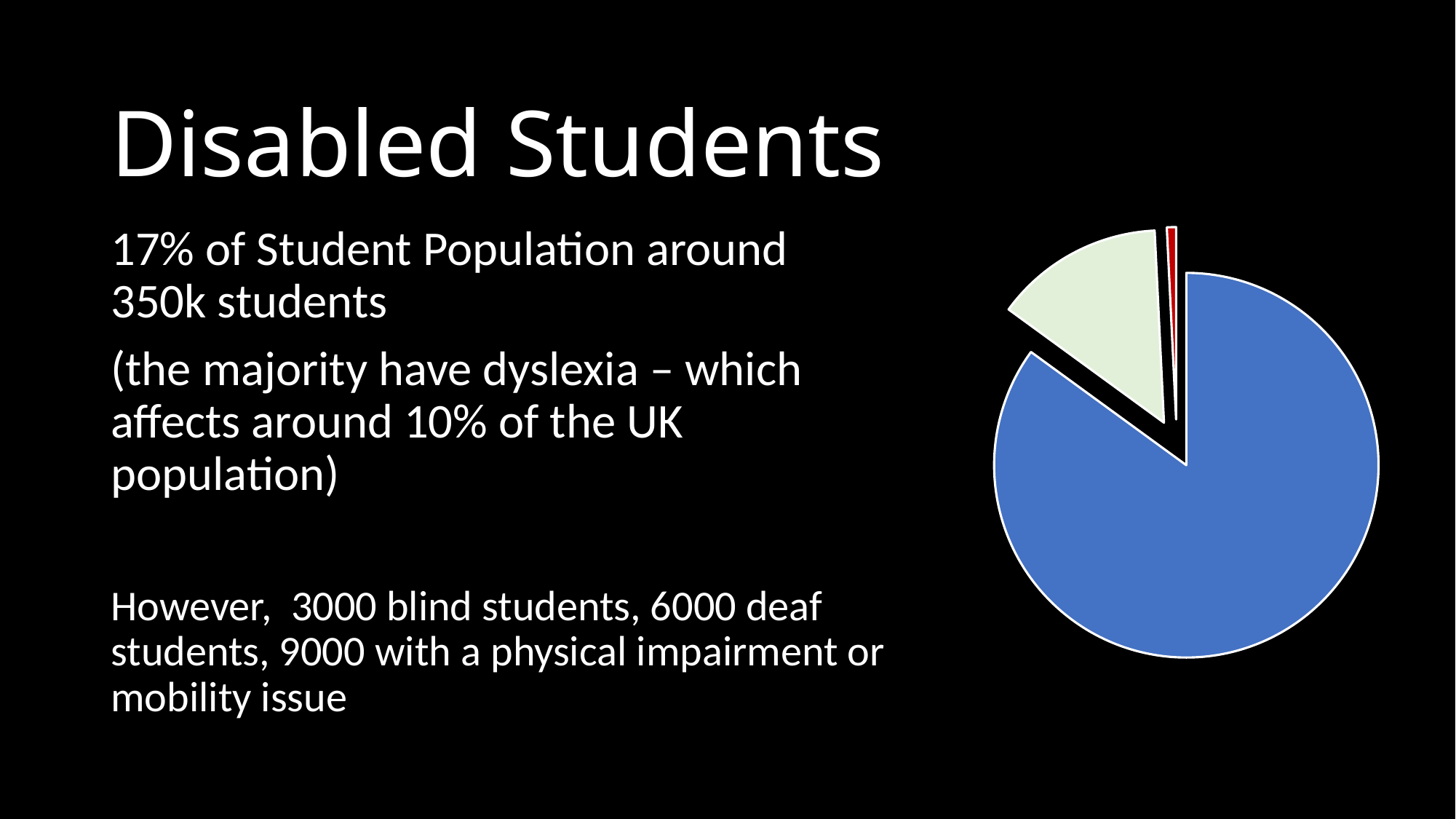
What kind of chart is shown on the slide? pie chart How many slices does the pie chart have? 3 Which is larger in the pie chart, the light green slice or the red slice? light green Are any data labels printed on the pie chart? No Which colour slice is the largest in the pie chart? blue Which colour slice is the smallest in the pie chart? red Does the pie chart have a legend? No Which is larger in the pie chart, the blue slice or the light green slice? blue